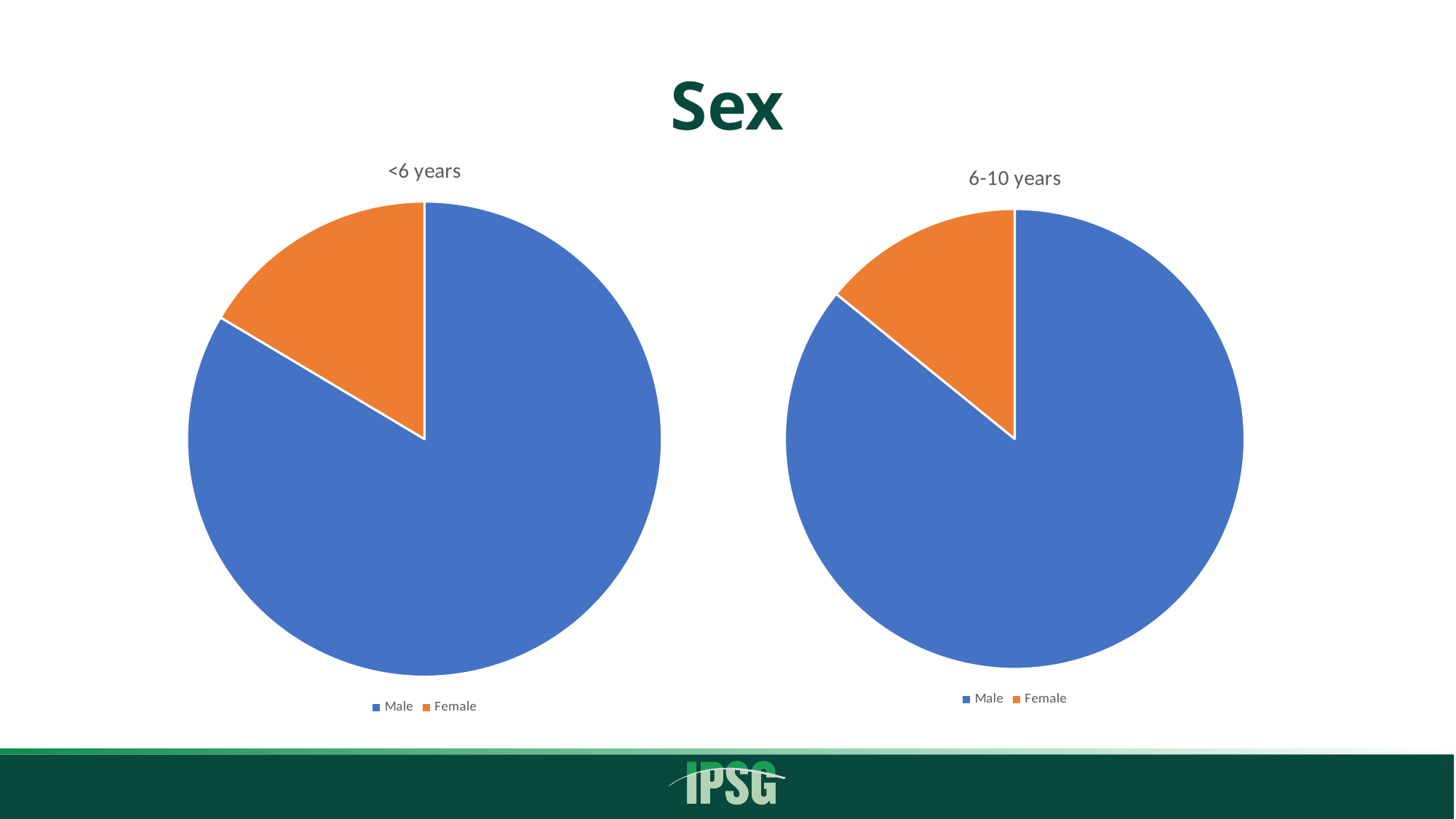
In the "6-10 years" chart, which category has the smallest slice? Female What kind of chart is the "6-10 years" chart? pie chart In the "<6 years" chart, which category has the largest slice? Male In the "<6 years" chart, which category has the smallest slice? Female What is the title of the slide above the two pie charts? Sex How many slices does the "<6 years" pie chart have? 2 What kind of chart is the "<6 years" chart? pie chart In the "<6 years" chart, what colour represents Female? orange In the "<6 years" chart, is the Male slice larger or smaller than the Female slice? larger How many entries does the legend of the "6-10 years" chart list? 2 In the "6-10 years" chart, which category has the largest slice? Male In the "6-10 years" chart, is the Female slice larger or smaller than the Male slice? smaller